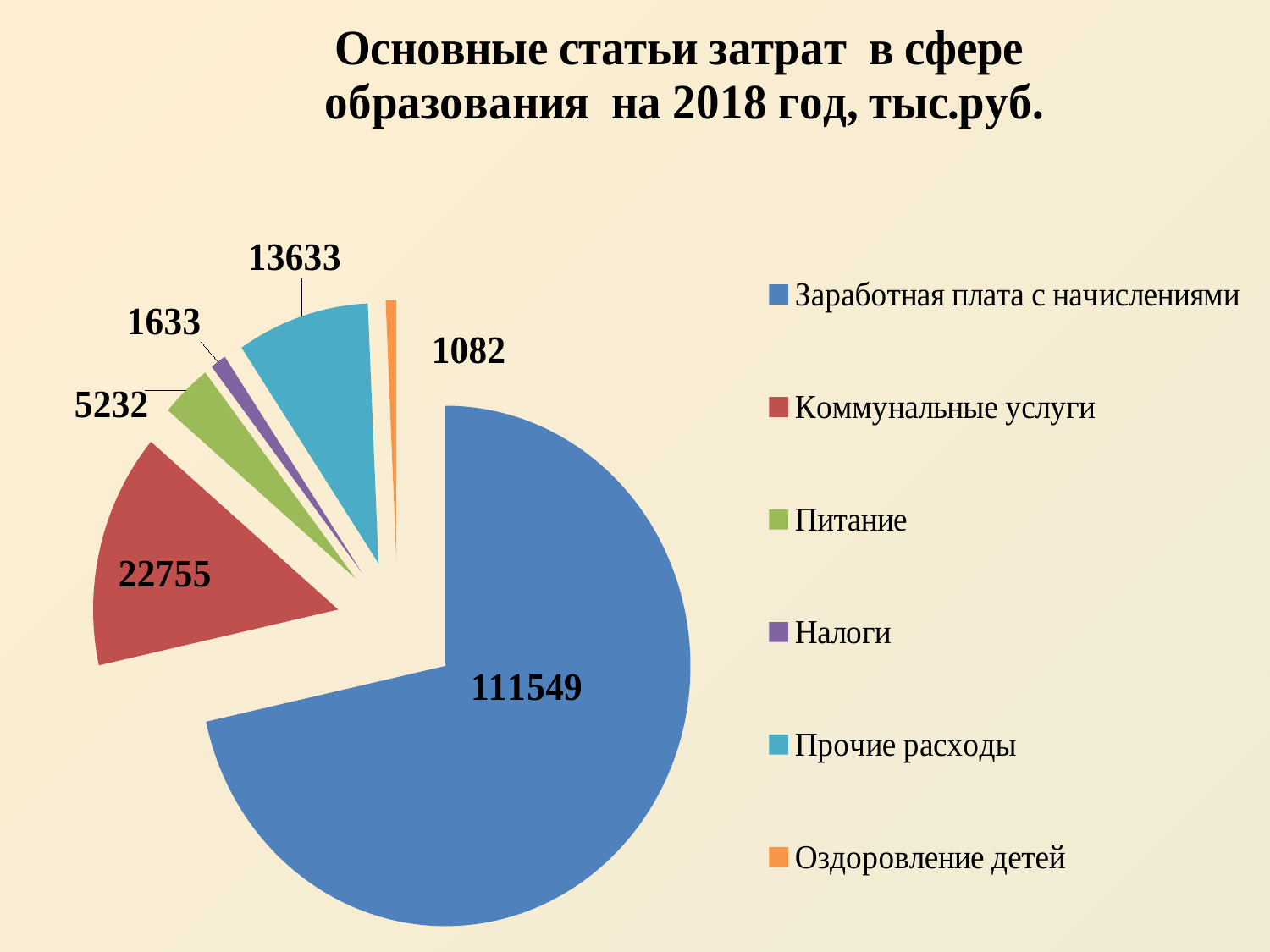
What is the title of the chart? Основные статьи затрат в сфере образования на 2018 год, тыс.руб. What is the difference between the values for Коммунальные услуги and Прочие расходы? 9122 What is the difference between the values for Питание and Налоги? 3599 Which category has the largest slice of the pie? Заработная плата с начислениями Which is larger, the value for Питание or the value for Налоги? Питание How many categories does the legend list? 6 What is the value for Оздоровление детей? 1082 Which category has the smallest slice of the pie? Оздоровление детей What is the value for Коммунальные услуги? 22755 What type of chart is shown on the slide? pie chart What is the value for Заработная плата с начислениями? 111549 What is the value for Прочие расходы? 13633